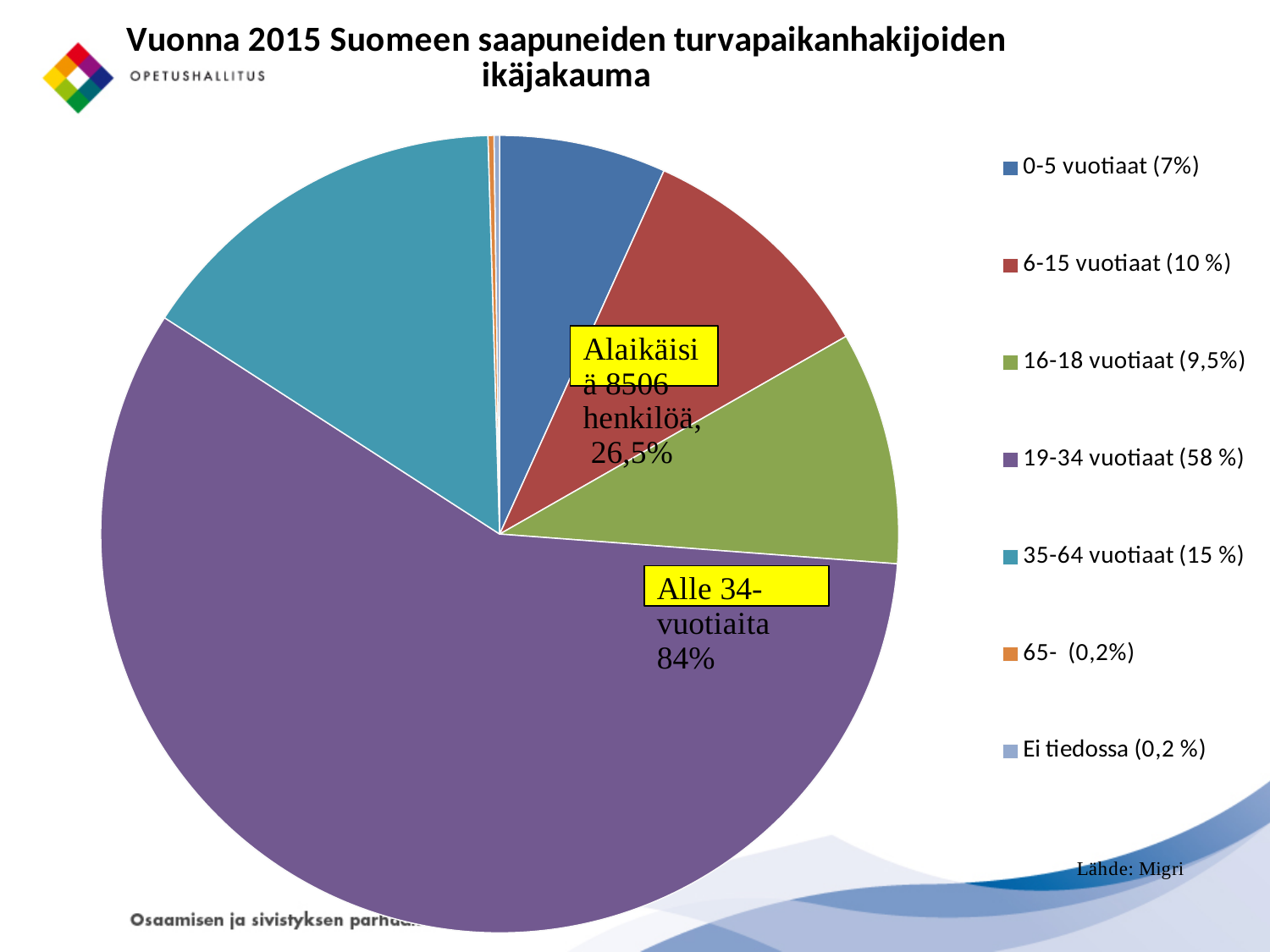
According to the annotation on the chart, what percentage of applicants were under 34 years old (Alle 34-vuotiaita)? 84% What percentage is shown for 35-64 vuotiaat? 15 % What is the difference in percentage points between the 19-34 vuotiaat share and the 35-64 vuotiaat share? 43 What percentage is shown for 16-18 vuotiaat? 9,5% Which age group has the largest slice of the pie? 19-34 vuotiaat What share of the pie does the 19-34 vuotiaat slice represent? 58 % Which is larger, the share for 6-15 vuotiaat or for 16-18 vuotiaat? 6-15 vuotiaat What is the difference in percentage points between the 6-15 vuotiaat share and the 0-5 vuotiaat share? 3 What is the title of the chart? Vuonna 2015 Suomeen saapuneiden turvapaikanhakijoiden ikäjakauma What kind of chart is shown on the slide? pie chart How many categories does the pie chart have? 7 What percentage is shown for 0-5 vuotiaat in the legend? 7%